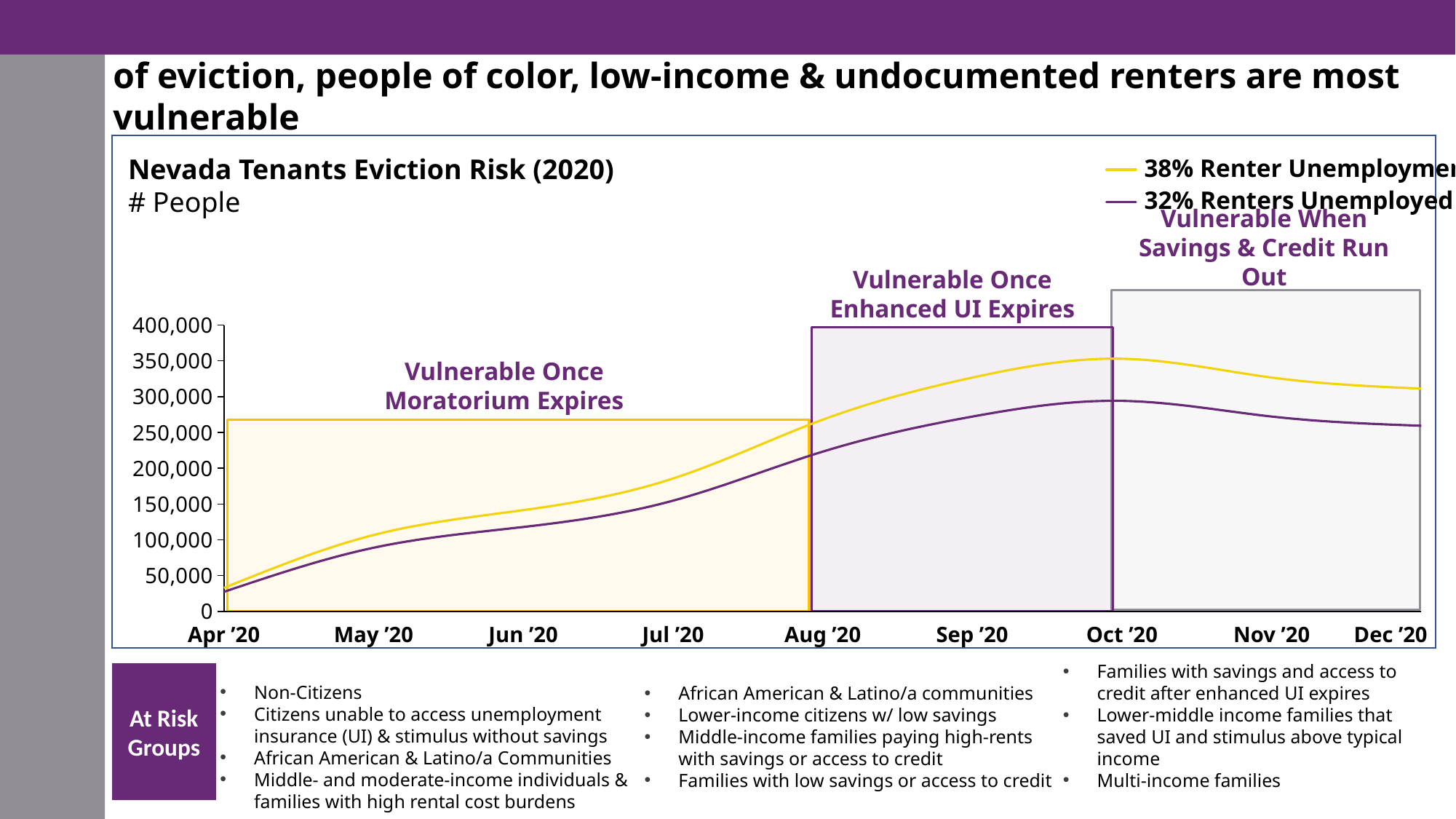
Is the value for 32% Renters Unemployed in Dec '20 greater or less than 300,000? less In Sep '20, which series has the higher value: 38% Renter Unemployment or 32% Renters Unemployed? 38% Renter Unemployment How many series does the chart legend list? 2 What kind of chart is shown on the slide? line chart Do the values of the 38% Renter Unemployment line rise or fall from Apr '20 to Oct '20? rise In which month is the 32% Renters Unemployed line at its lowest value? Apr '20 Is the value for 32% Renters Unemployed in Jun '20 greater or less than 150,000? less How many months are labelled along the x axis of the chart? 9 Is the value for 38% Renter Unemployment in Oct '20 greater or less than 300,000? greater What is the title of the chart? Nevada Tenants Eviction Risk (2020) Which colour is used for the 38% Renter Unemployment series? yellow In which month does the 38% Renter Unemployment line reach its highest value? Oct '20